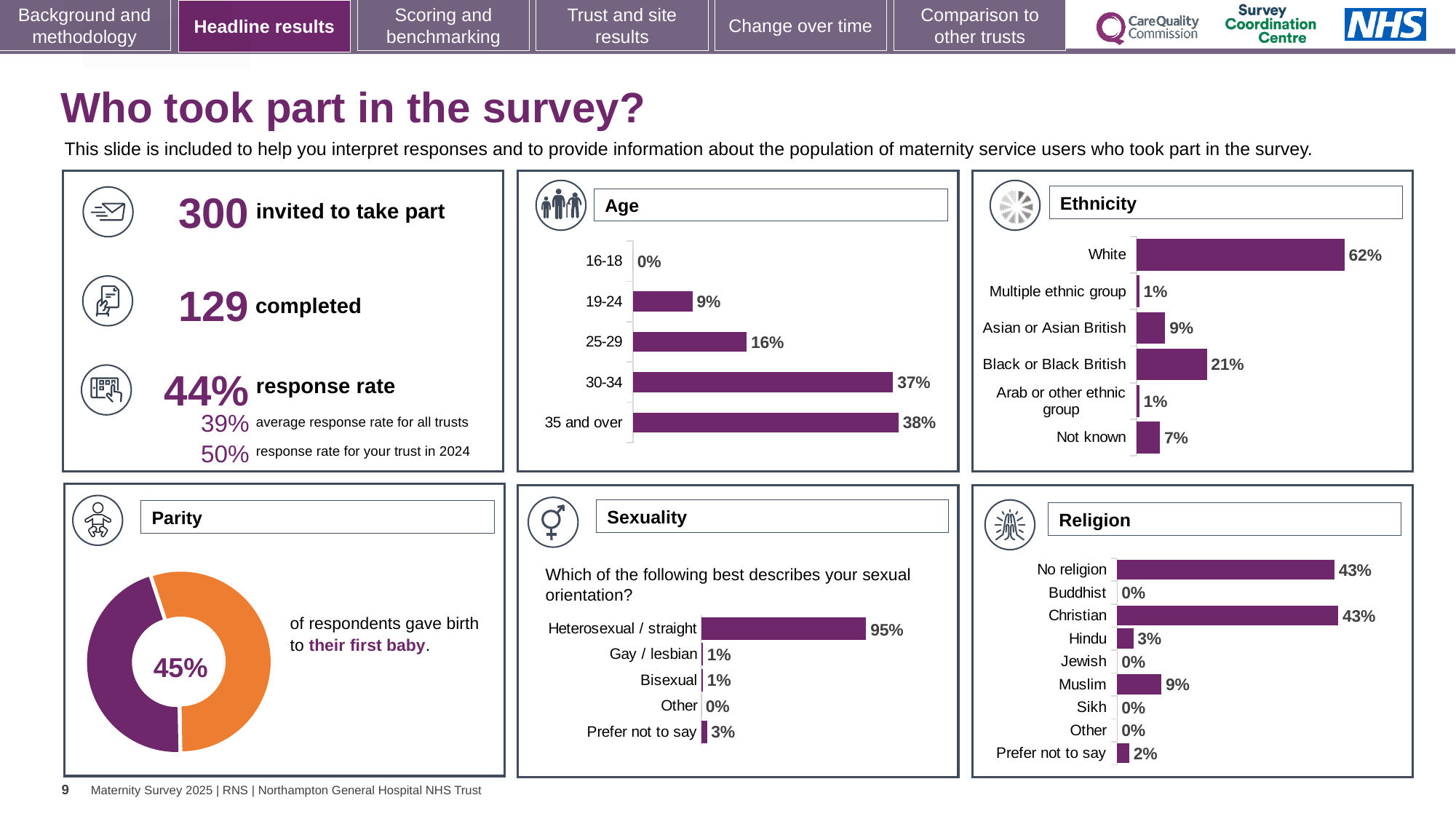
In the Ethnicity chart, what is the value for Black or Black British? 21% In the Sexuality chart, what is the value for Heterosexual / straight? 95% In the Ethnicity chart, what is the difference between the values for White and Black or Black British? 41% In the Religion chart, which is larger, the value for Hindu or the value for Prefer not to say? Hindu In the Age chart, what percentage of respondents were aged 25-29? 16% In the Age chart, which age group has the lowest value? 16-18 In the Parity donut chart, what share of respondents gave birth to their first baby? 45% In the Ethnicity chart, which category has the highest value? White How many categories are shown in the Sexuality chart? 5 How many categories are shown in the Religion chart? 9 In the Religion chart, what is the value for Muslim? 9% What kind of chart is the Age chart? bar chart